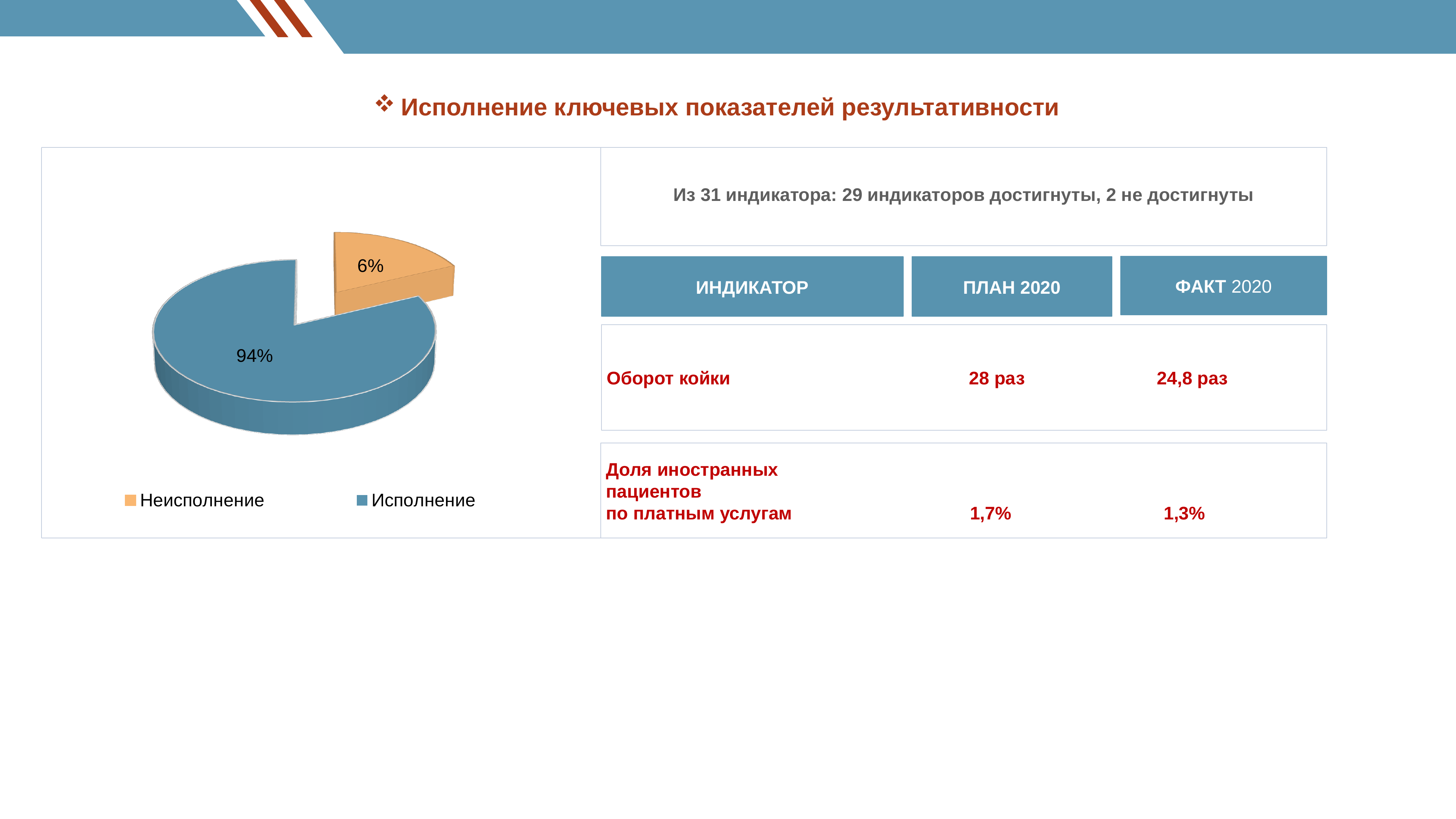
What colour is the Исполнение slice in the pie chart? Blue How many slices does the pie chart have? 2 What colour is the Неисполнение slice in the pie chart? Orange What is the difference in percentage points between the Исполнение and Неисполнение slices? 88% What share of the pie chart does Неисполнение take? 6% Which is larger in the pie chart, Исполнение or Неисполнение? Исполнение How many entries does the pie chart legend list? 2 What kind of chart is shown on the left of the slide? Pie chart Which slice of the pie chart is the largest? Исполнение Which slice of the pie chart is the smallest? Неисполнение What share of the pie chart does Исполнение take? 94%